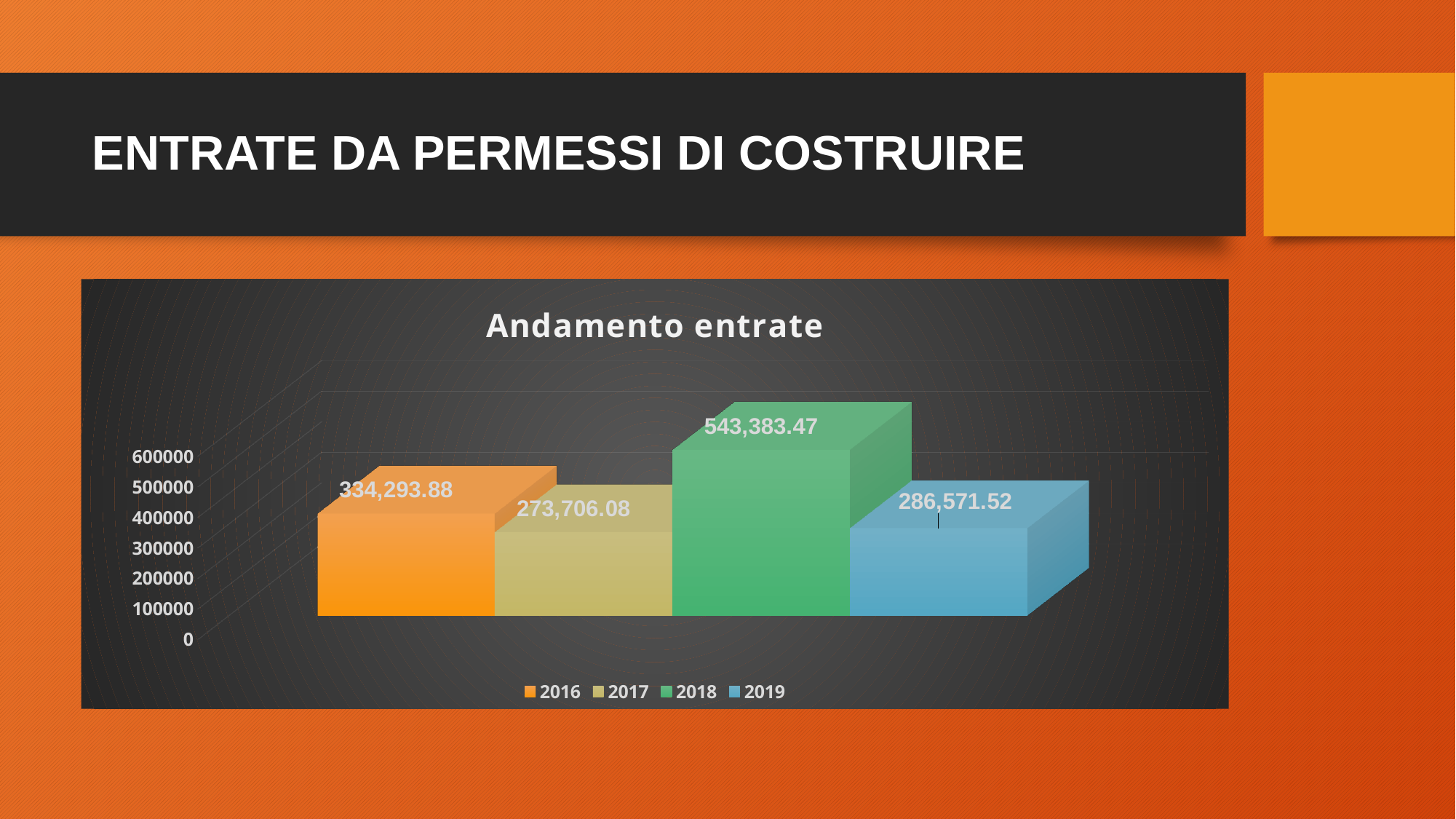
What kind of chart is the Andamento entrate chart? Bar chart What is the value for 2018 in the Andamento entrate chart? 543,383.47 Which year has the highest value in the Andamento entrate chart? 2018 Which year has the lowest value in the Andamento entrate chart? 2017 What is the value for 2016 in the Andamento entrate chart? 334,293.88 Which is larger in the Andamento entrate chart, the value for 2016 or the value for 2019? 2016 What is the difference between the 2016 and 2017 values in the Andamento entrate chart? 60,587.80 What is the value for 2019 in the Andamento entrate chart? 286,571.52 What is the value for 2017 in the Andamento entrate chart? 273,706.08 What is the difference between the 2018 and 2016 values in the Andamento entrate chart? 209,089.59 How many series does the legend of the Andamento entrate chart list? 4 What is the title of the chart on the slide? Andamento entrate